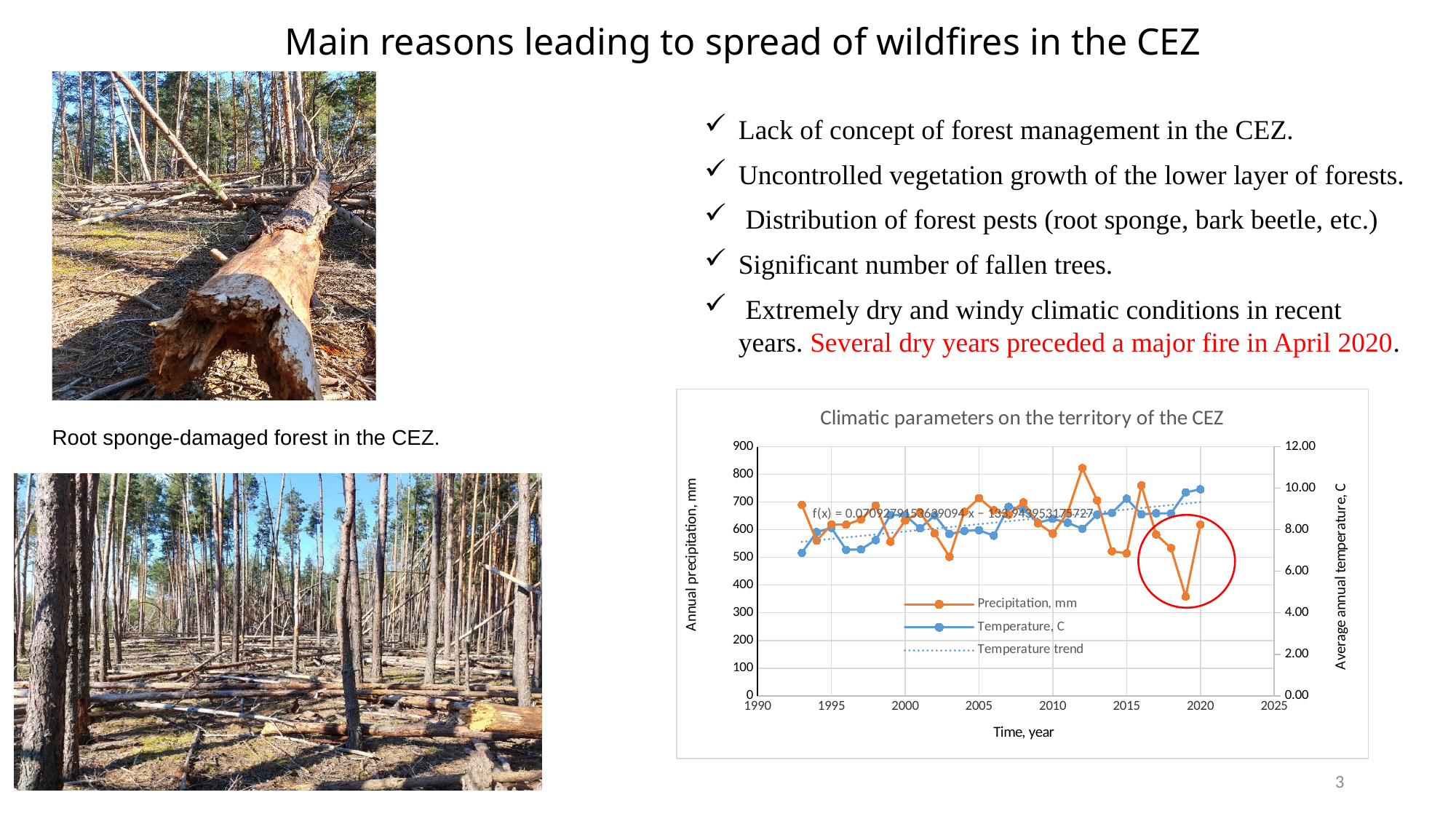
In which year is the annual precipitation highest? 2012 Which year has the larger annual precipitation, 2012 or 2019? 2012 Is the temperature value for 1993 greater or less than 8.00? less Is the precipitation value for 2019 greater or less than 400? less How many series does the legend of the chart list? 3 Does the temperature trend line rise or fall over the years? rise Is the precipitation value for 2012 greater or less than 700? greater What is the title of the chart? Climatic parameters on the territory of the CEZ What is the label of the x axis of the chart? Time, year In which year is the annual precipitation lowest? 2019 What kind of chart is shown on the slide? line chart